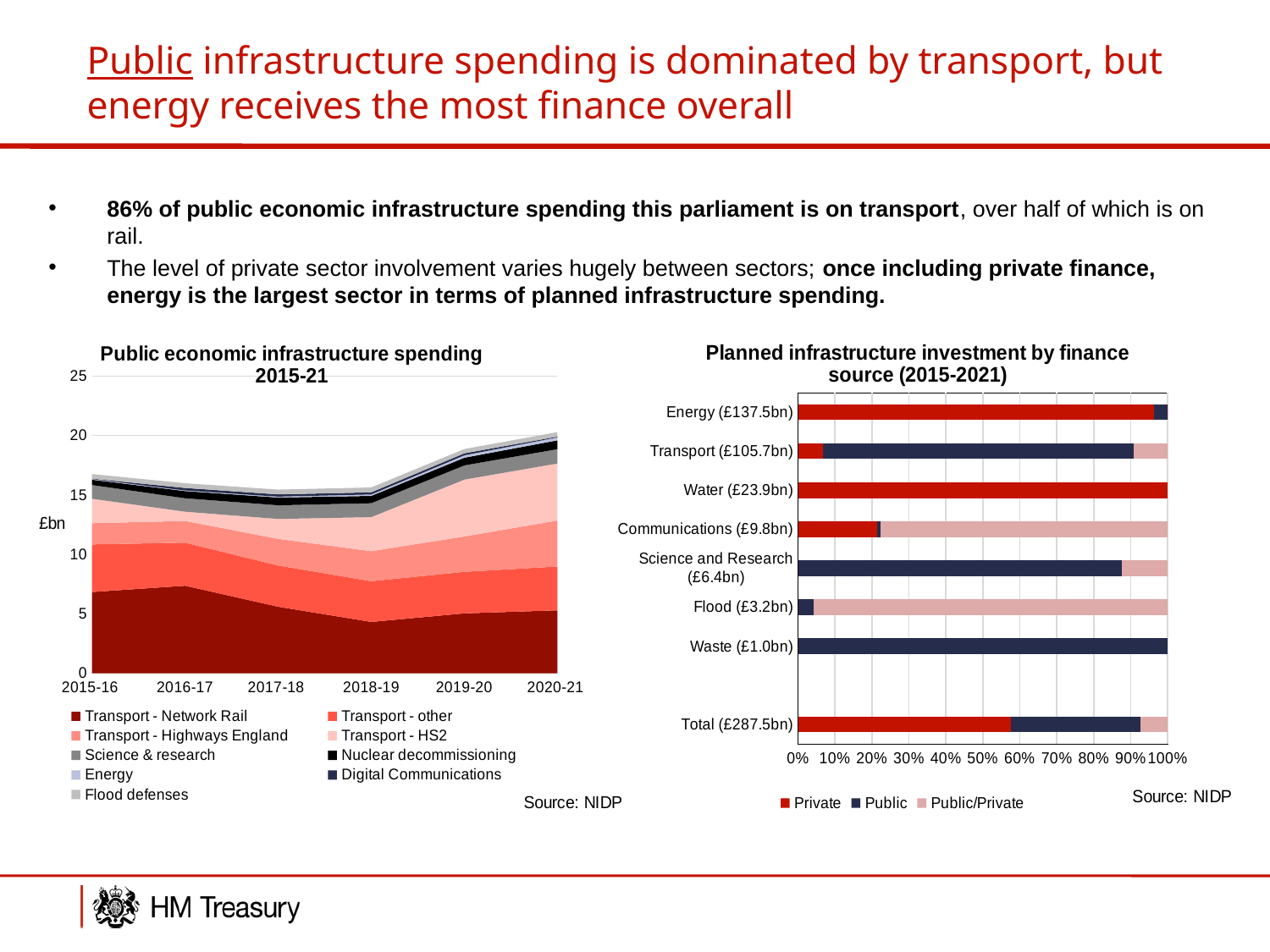
In the right chart, 'Planned infrastructure investment by finance source (2015-2021)', what is the Total planned investment amount shown? £287.5bn In the right chart, 'Planned infrastructure investment by finance source (2015-2021)', what is the difference between the Energy and Transport investment amounts? £31.8bn What kind of chart is the left chart, 'Public economic infrastructure spending 2015-21'? Area chart In the right chart, 'Planned infrastructure investment by finance source (2015-2021)', which sector has the largest planned investment amount? Energy (£137.5bn) In the left chart, 'Public economic infrastructure spending 2015-21', how many series does the legend list? 9 In the right chart, 'Planned infrastructure investment by finance source (2015-2021)', is the Public share of the Flood bar greater or less than 10%? less In the right chart, 'Planned infrastructure investment by finance source (2015-2021)', what is the planned investment amount shown for Water? £23.9bn In the right chart, 'Planned infrastructure investment by finance source (2015-2021)', how many bars are shown, including the Total bar? 8 In the right chart, 'Planned infrastructure investment by finance source (2015-2021)', how many series does the legend list? 3 In the right chart, 'Planned infrastructure investment by finance source (2015-2021)', is the Private share of the Energy bar greater or less than 90%? greater In the left chart, 'Public economic infrastructure spending 2015-21', does total spending rise or fall between 2018-19 and 2020-21? Rise In the left chart, 'Public economic infrastructure spending 2015-21', how many years are shown on the x axis? 6